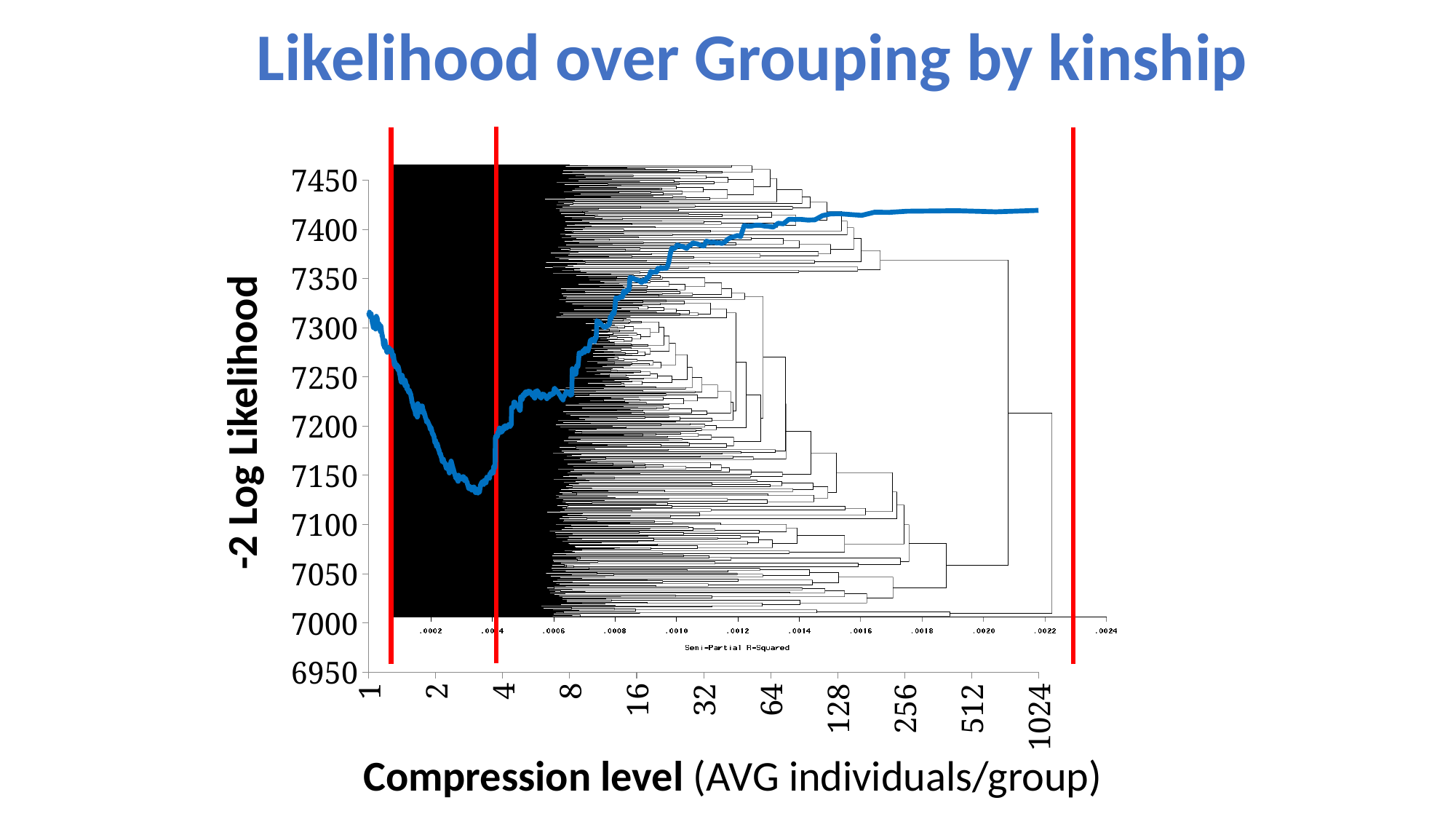
Is the value of the blue line at compression level 128 greater or less than 7400? greater How many tick labels are shown on the x axis (Compression level)? 11 Is the value of the blue line at compression level 8 greater or less than 7300? less Is the lowest value reached by the blue line greater or less than 7100? greater What is the title of the chart? Likelihood over Grouping by kinship What kind of chart is shown on the slide? line chart Does the blue line rise or fall as compression level increases from 1 to 2? fall What is the label of the y axis? -2 Log Likelihood Does the blue line rise or fall as compression level increases from 8 to 1024? rise